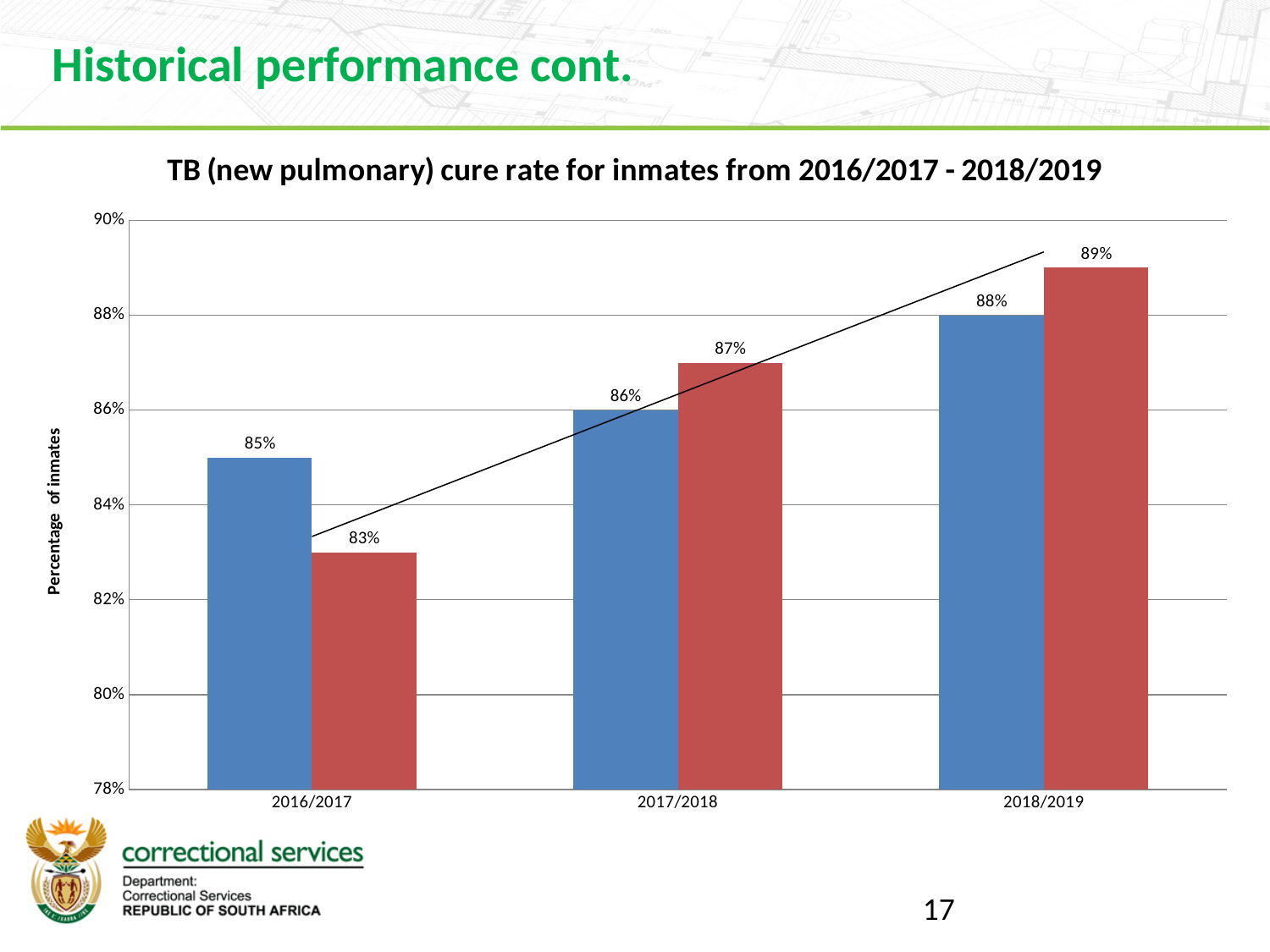
What is the difference between the red bar values for 2018/2019 and 2016/2017? 6% How many year categories are shown on the x axis? 3 What is the value of the blue bar for 2016/2017? 85% What is the title of the chart? TB (new pulmonary) cure rate for inmates from 2016/2017 - 2018/2019 Which year has the lowest blue bar value? 2016/2017 What is the value of the blue bar for 2018/2019? 88% Which year has the highest red bar value? 2018/2019 What type of chart is shown on the slide? bar chart For 2017/2018, which is larger, the blue bar or the red bar? the red bar What is the value of the red bar for 2016/2017? 83% What is the value of the red bar for 2017/2018? 87% Do the blue bar values rise or fall from 2016/2017 to 2018/2019? rise